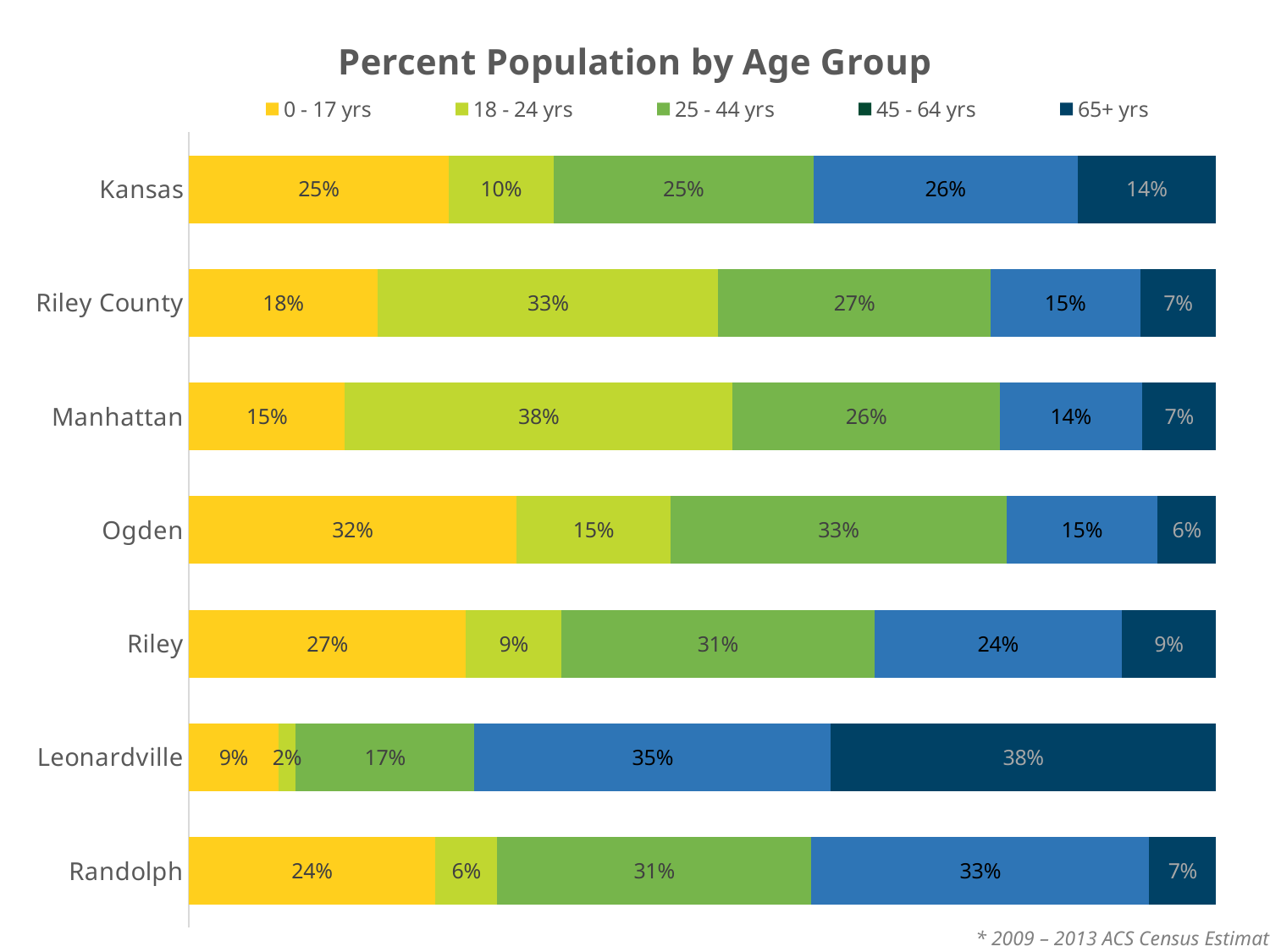
What percent of Ogden's population is in the 0 - 17 yrs group? 32% Which is larger: Randolph's 45 - 64 yrs share or Riley's 45 - 64 yrs share? Randolph's 45 - 64 yrs share How many age-group series does the legend list? 5 What is the total of the Kansas bar across all five age groups? 100% Which place has the highest percentage in the 0 - 17 yrs group? Ogden What percent of Manhattan's population is in the 18 - 24 yrs group? 38% What type of chart is shown on the slide? Stacked bar chart How many places (categories) are shown on the chart? 7 What percent of Leonardville's population is 65+ yrs? 38% What is the title of the chart? Percent Population by Age Group What is the difference between Riley County's and Kansas's 18 - 24 yrs percentages? 23% Which place has the lowest percentage in the 18 - 24 yrs group? Leonardville